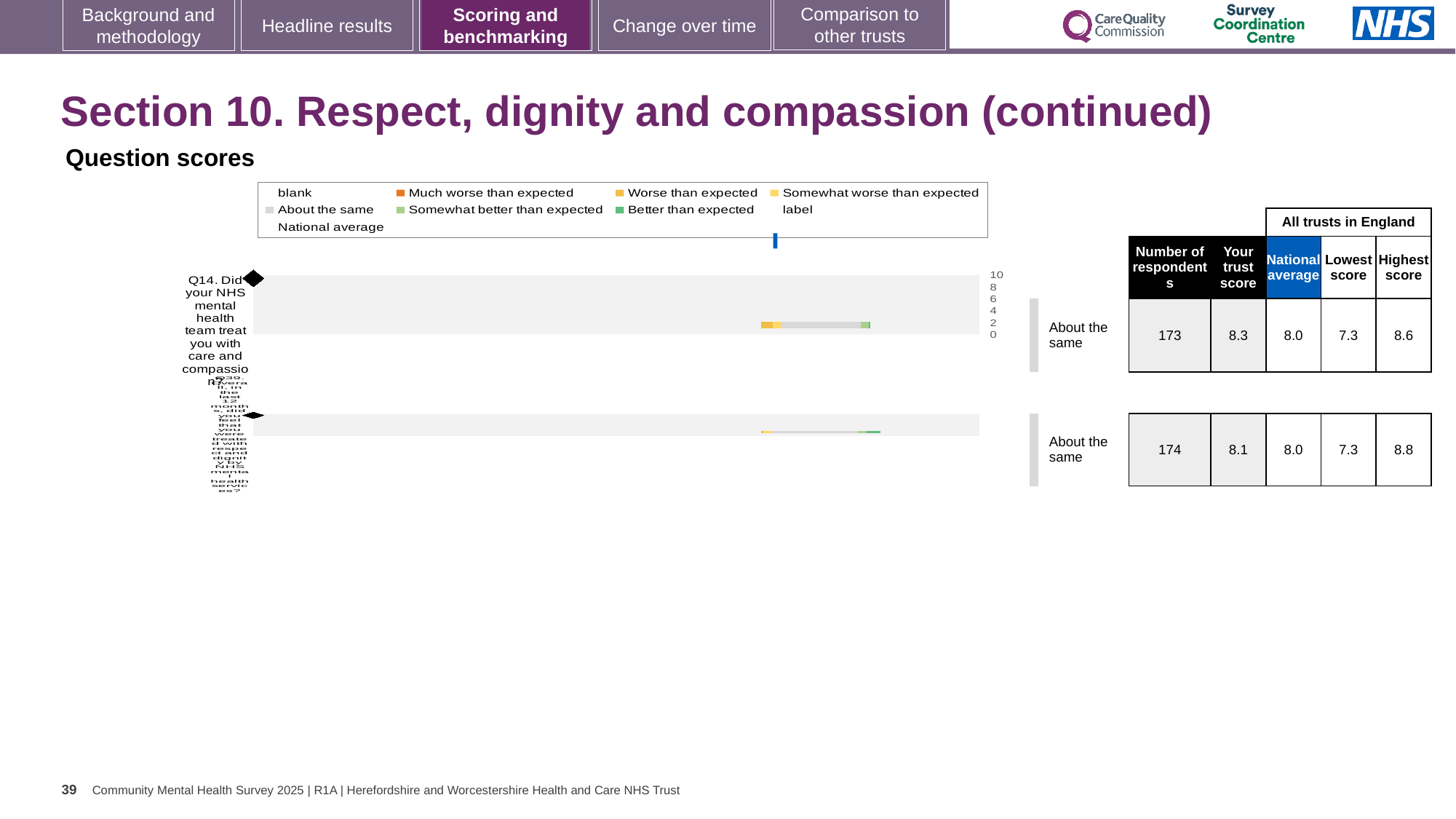
What is the difference between the highest and lowest scores for Q39? 1.5 How many respondents answered Q14? 173 How many respondents answered Q39? 174 How many questions are plotted in the question scores chart? 2 Which question has the higher trust score, Q14 or Q39? Q14 What is the highest score among all trusts in England for Q39? 8.8 Which question has the higher 'Highest score' across all trusts in England, Q14 or Q39? Q39 What is the national average score for Q14? 8.0 What benchmarking category is shown for Q14 in the question scores chart? About the same By how much does the trust score for Q14 exceed the national average for Q14? 0.3 What is the trust score for Q14 (Did your NHS mental health team treat you with care and compassion?)? 8.3 What is the lowest score among all trusts in England for Q14? 7.3